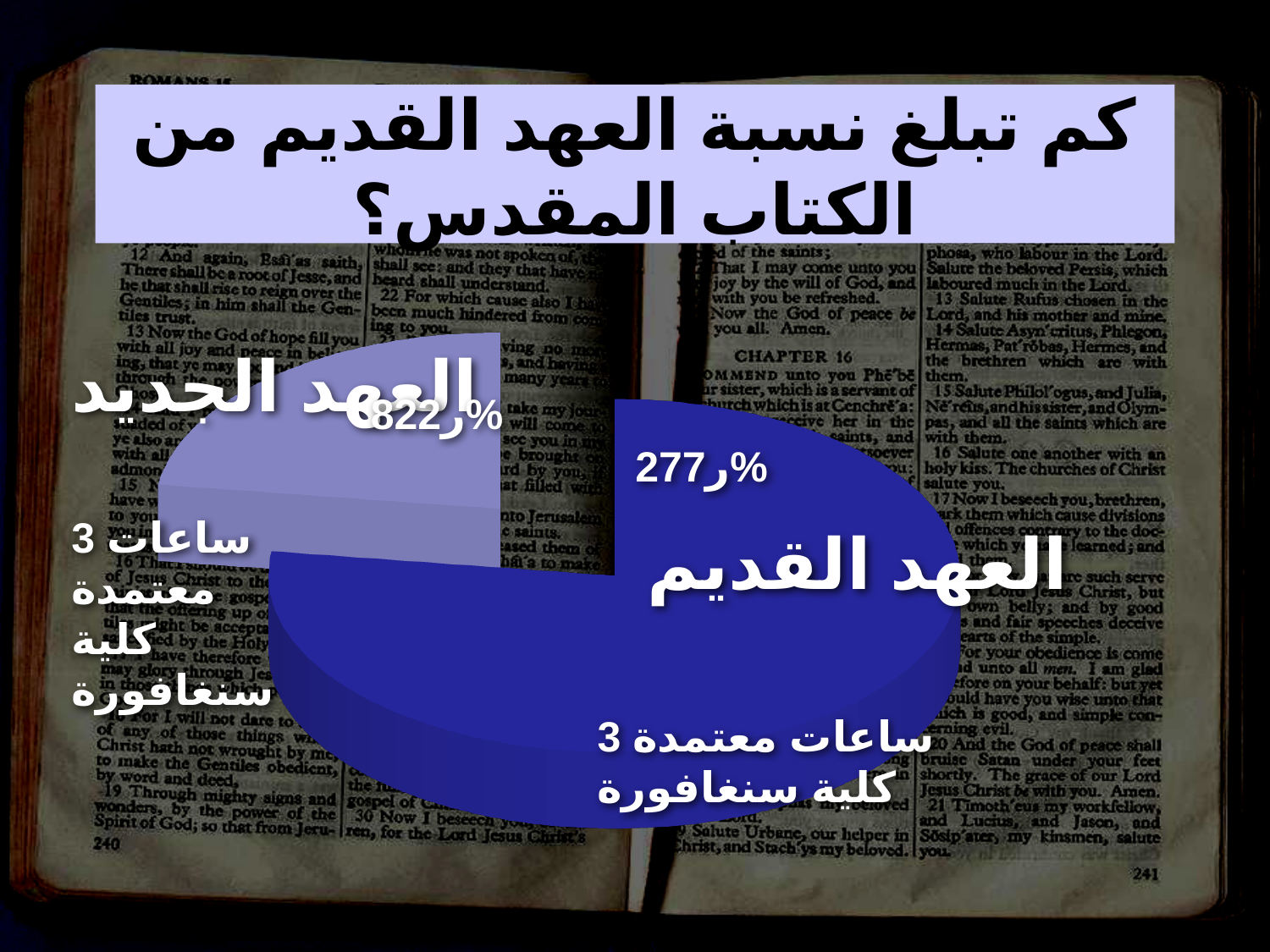
What is the title of the slide containing the pie chart? كم تبلغ نسبة العهد القديم من الكتاب المقدس؟ Which slice of the pie chart is the smallest? العهد الجديد Does the العهد الجديد slice take up more or less than a quarter of the pie? less What percentage is shown for the العهد الجديد slice? 22,8% What kind of chart is shown on the slide? pie chart How many slices does the pie chart have? 2 Which slice is larger, العهد القديم or العهد الجديد? العهد القديم Which slice of the pie chart is the largest? العهد القديم Does the العهد القديم slice take up more or less than half of the pie? more Which slice of the pie chart is drawn in the darker blue colour? العهد القديم What percentage is shown for the العهد القديم slice? 77,2%